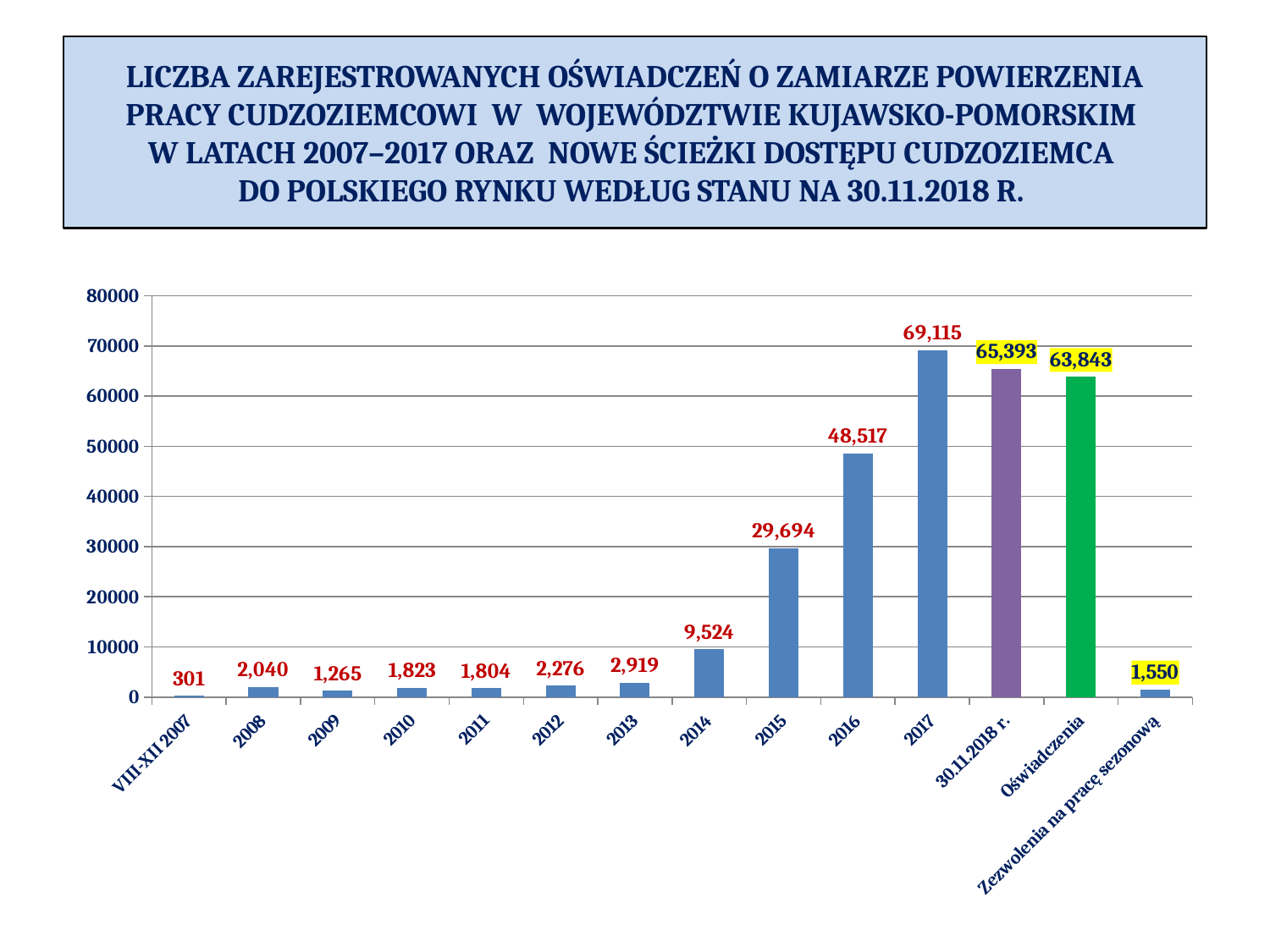
What colour is the bar for Oświadczenia? green What is the value for 30.11.2018 r.? 65,393 Which category has the lowest value? VIII-XII 2007 What is the value for 2017? 69,115 Which is larger, the value for 2010 or the value for 2011? 2010 How many bars are shown in the chart? 14 What is the value for VIII-XII 2007? 301 What is the value for Zezwolenia na pracę sezonową? 1,550 Is the value for 2015 greater or less than 30000? less What kind of chart is shown on the slide? bar chart What is the difference between the values for 2017 and 2016? 20,598 Which category has the highest value? 2017